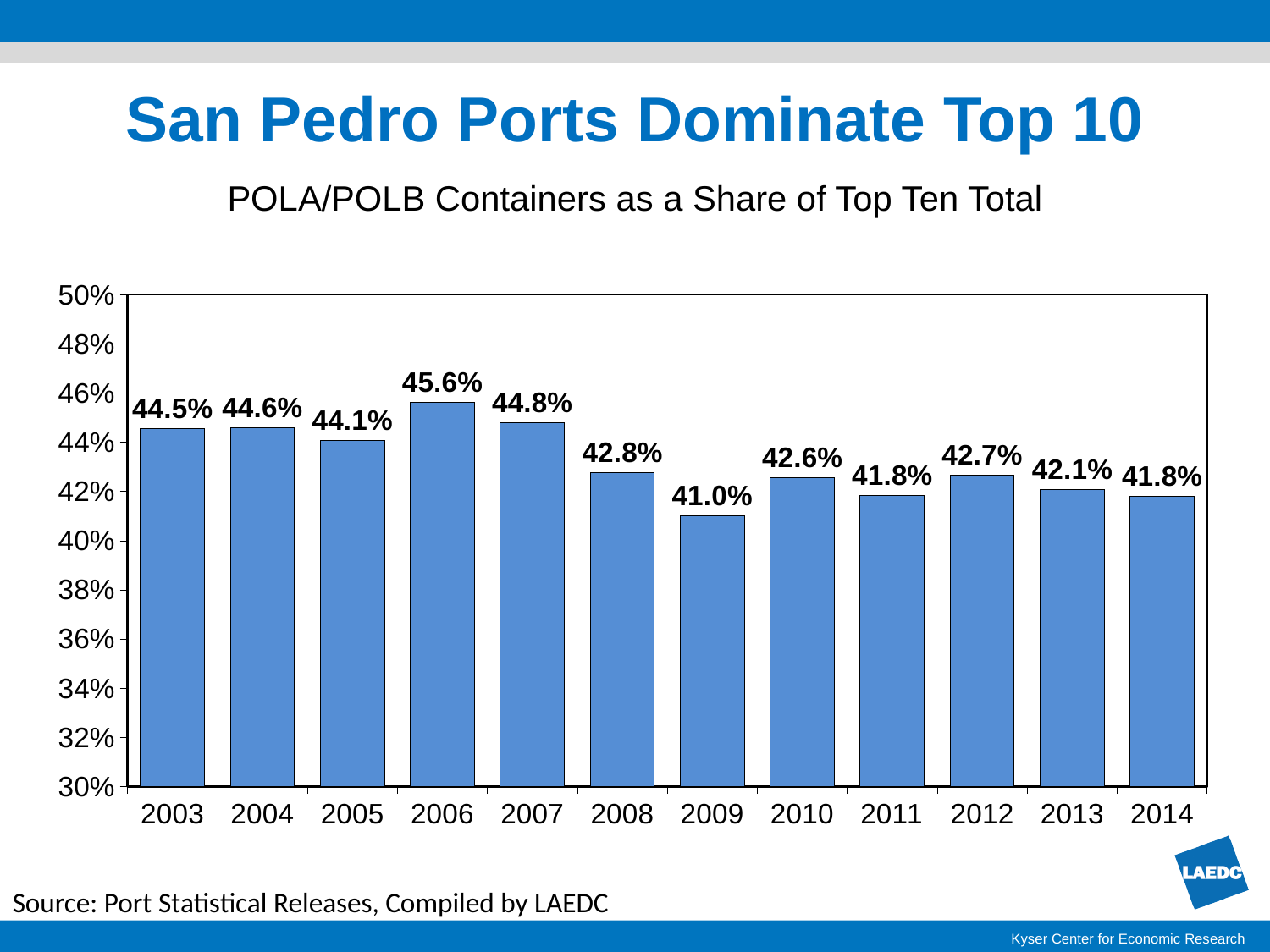
What kind of chart is shown on the slide? Bar chart What is the difference between the 2006 value and the 2009 value? 4.6 percentage points Is the value for 2010 greater or less than 44%? less Which year has a larger share, 2007 or 2008? 2007 What is the difference between the 2003 value and the 2014 value? 2.7 percentage points What is the POLA/POLB share of the top ten total in 2009? 41.0% What is the POLA/POLB share of the top ten total in 2006? 45.6% What is the subtitle describing the chart's data? POLA/POLB Containers as a Share of Top Ten Total Which year has the highest POLA/POLB share of the top ten total? 2006 How many years are shown on the x axis? 12 What is the value shown for 2014? 41.8% Which year has the lowest POLA/POLB share of the top ten total? 2009